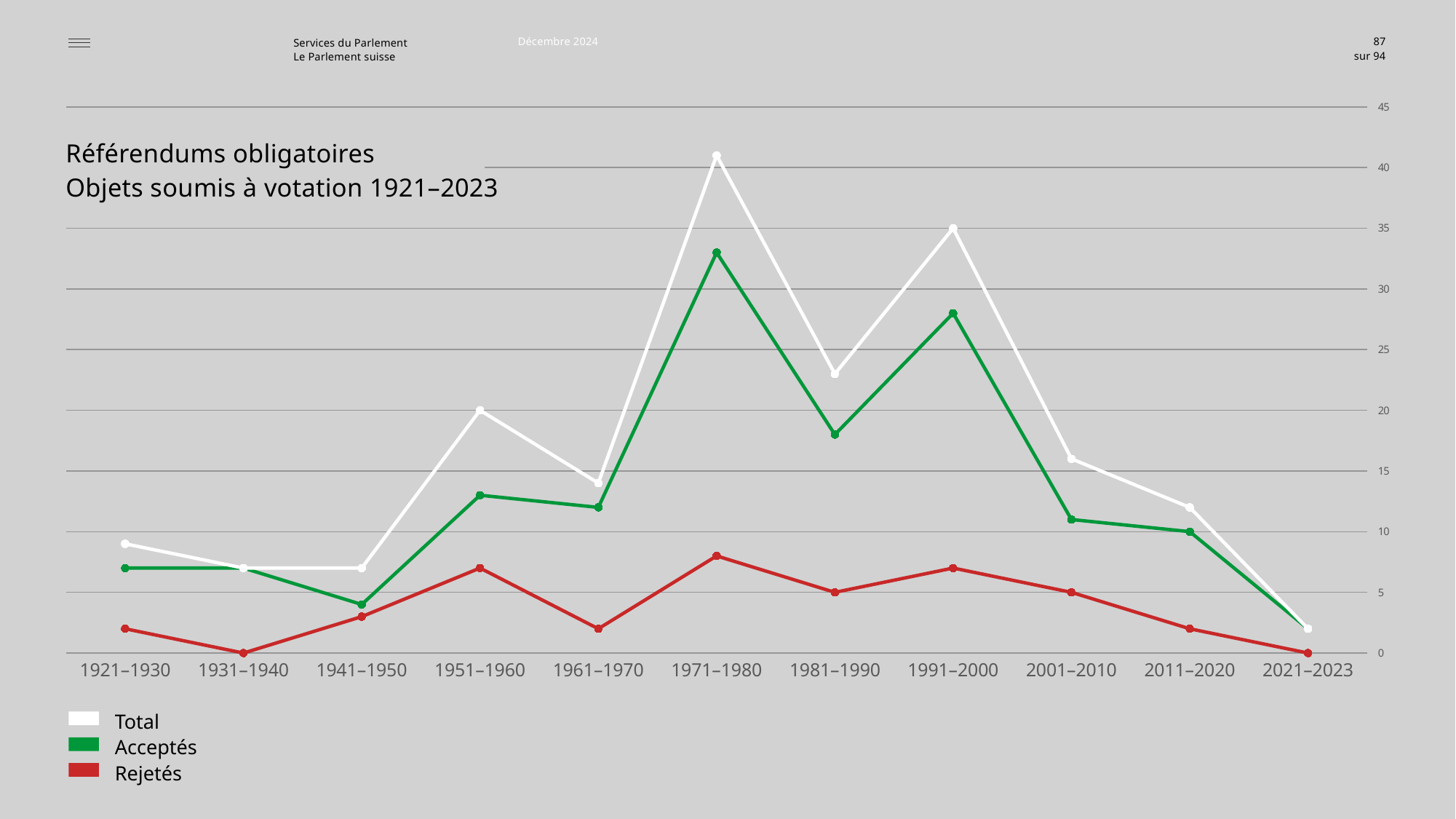
What kind of chart is shown on the slide? line chart What is the Total value for 1991–2000? 35 What is the Rejetés value for 1981–1990? 5 What is the Acceptés value for 2011–2020? 10 What is the Total value for 1951–1960? 20 How many series does the legend list? 3 In which period is the Total series highest? 1971–1980 How many periods are shown along the x axis? 11 Is the Total value for 1971–1980 greater or less than 40? greater In which period is the Acceptés series lowest? 2021–2023 Which is larger in 1991–2000, Acceptés or Rejetés? Acceptés Does the Total series rise or fall from 1991–2000 to 2021–2023? fall